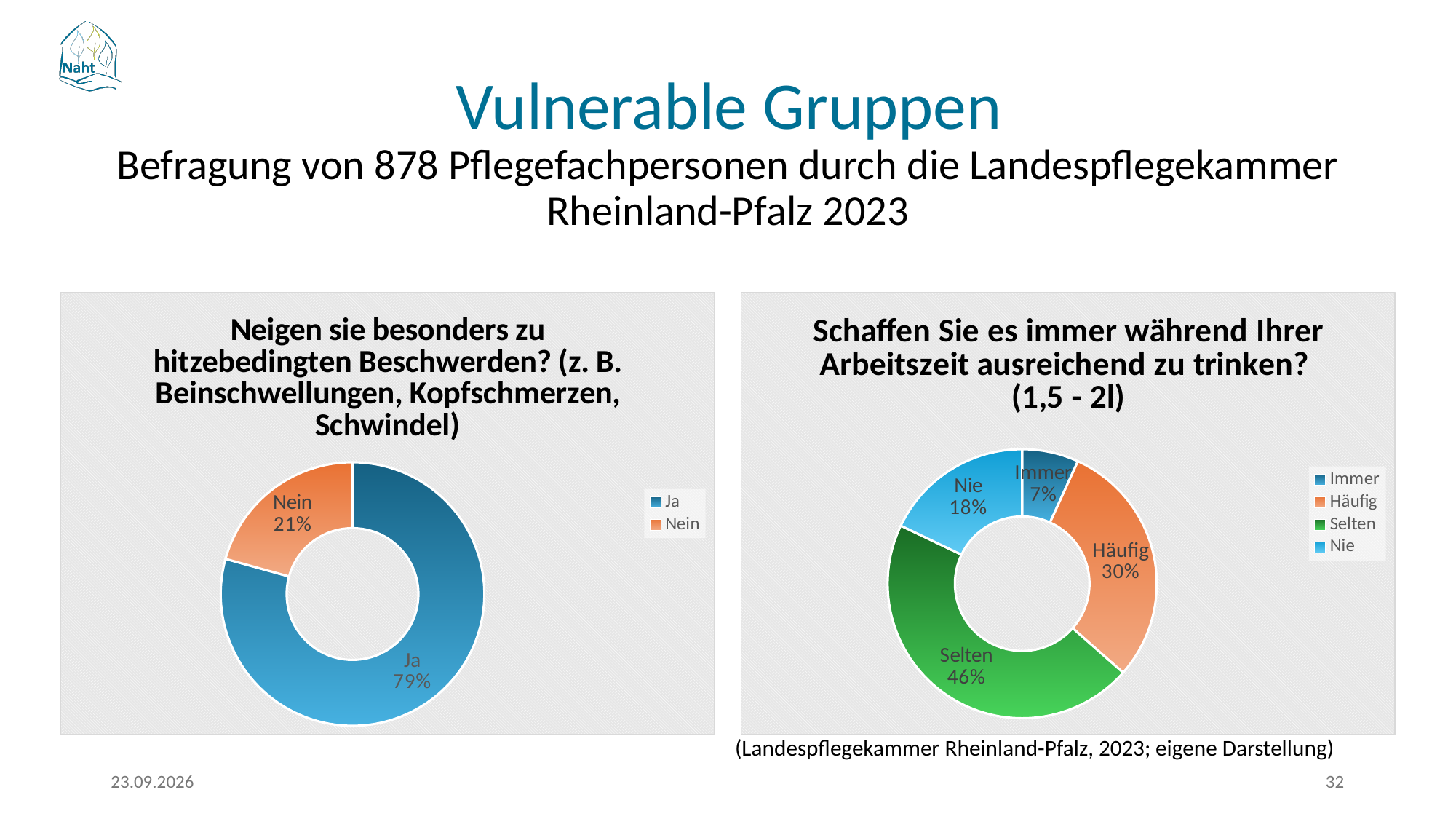
In the left chart (Neigen sie besonders zu hitzebedingten Beschwerden?), what kind of chart is shown? Doughnut (pie) chart In the right chart (Schaffen Sie es immer während Ihrer Arbeitszeit ausreichend zu trinken?), what share of respondents answered Selten? 46% In the right chart (Schaffen Sie es immer während Ihrer Arbeitszeit ausreichend zu trinken?), which is larger, Häufig or Nie? Häufig In the right chart (Schaffen Sie es immer während Ihrer Arbeitszeit ausreichend zu trinken?), what share of respondents answered Nie? 18% In the right chart (Schaffen Sie es immer während Ihrer Arbeitszeit ausreichend zu trinken?), which category has the largest share? Selten In the right chart (Schaffen Sie es immer während Ihrer Arbeitszeit ausreichend zu trinken?), what share of respondents answered Immer? 7% In the left chart (Neigen sie besonders zu hitzebedingten Beschwerden?), what share of respondents answered Ja? 79% In the left chart (Neigen sie besonders zu hitzebedingten Beschwerden?), what share of respondents answered Nein? 21% In the right chart (Schaffen Sie es immer während Ihrer Arbeitszeit ausreichend zu trinken?), how many categories does the legend list? 4 In the right chart (Schaffen Sie es immer während Ihrer Arbeitszeit ausreichend zu trinken?), which category has the smallest share? Immer In the right chart (Schaffen Sie es immer während Ihrer Arbeitszeit ausreichend zu trinken?), what is the difference in percentage points between Selten and Häufig? 16 In the left chart (Neigen sie besonders zu hitzebedingten Beschwerden?), what is the difference in percentage points between Ja and Nein? 58